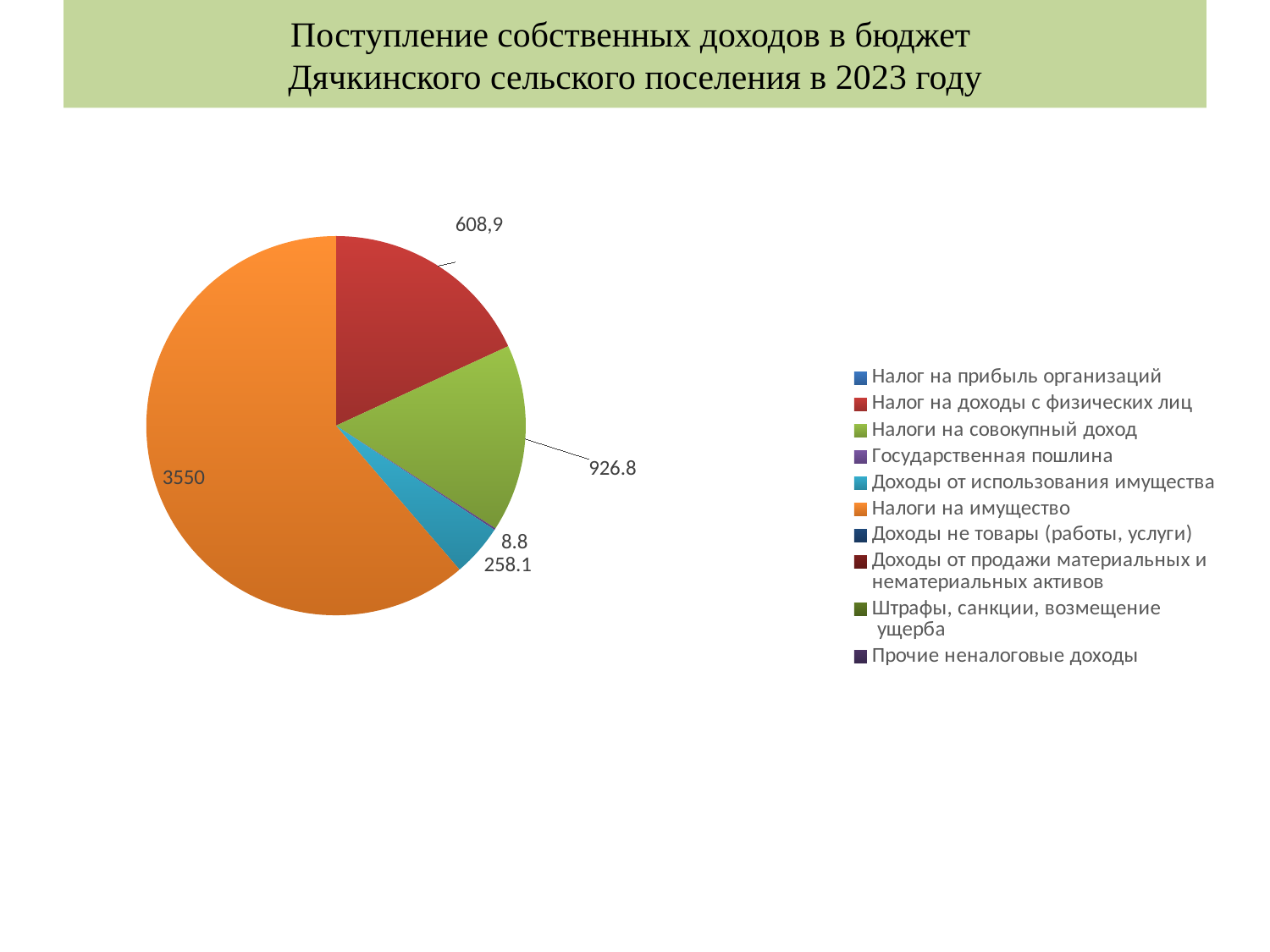
What is the value of the slice for Налог на доходы с физических лиц? 608,9 What is the value of the slice for Доходы от использования имущества? 258.1 How many entries does the legend list? 10 What colour is the slice for Налоги на имущество? orange What is the title of the slide containing the chart? Поступление собственных доходов в бюджет Дячкинского сельского поселения в 2023 году What is the value of the slice for Государственная пошлина? 8.8 What is the value of the slice for Налоги на имущество? 3550 What kind of chart is shown on the slide? pie chart Which category has the largest slice of the pie? Налоги на имущество What is the value of the slice for Налоги на совокупный доход? 926.8